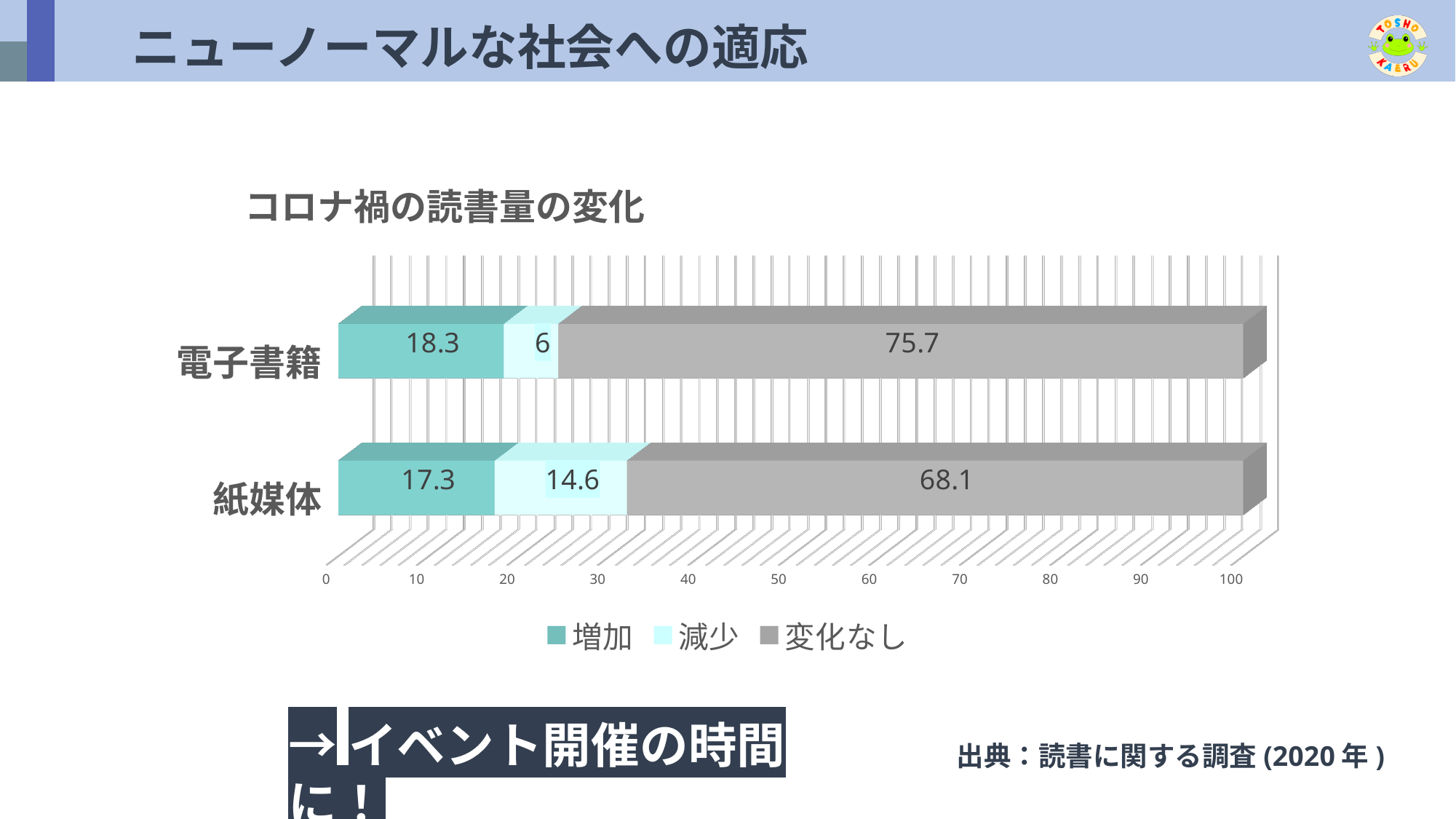
What is the value of 変化なし for 電子書籍? 75.7 Which category has the higher 変化なし value, 電子書籍 or 紙媒体? 電子書籍 What is the value of 減少 for 紙媒体? 14.6 What is the value of 減少 for 電子書籍? 6 How many series does the legend list? 3 How many categories are shown on the vertical axis of the chart? 2 What is the value of 増加 for 電子書籍 in the chart コロナ禍の読書量の変化? 18.3 What is the title of the chart? コロナ禍の読書量の変化 What kind of chart is shown on the slide? Stacked bar chart What is the total of the stacked bar for 紙媒体? 100 What is the difference between the 変化なし values for 電子書籍 and 紙媒体? 7.6 What is the difference between the 減少 values for 紙媒体 and 電子書籍? 8.6